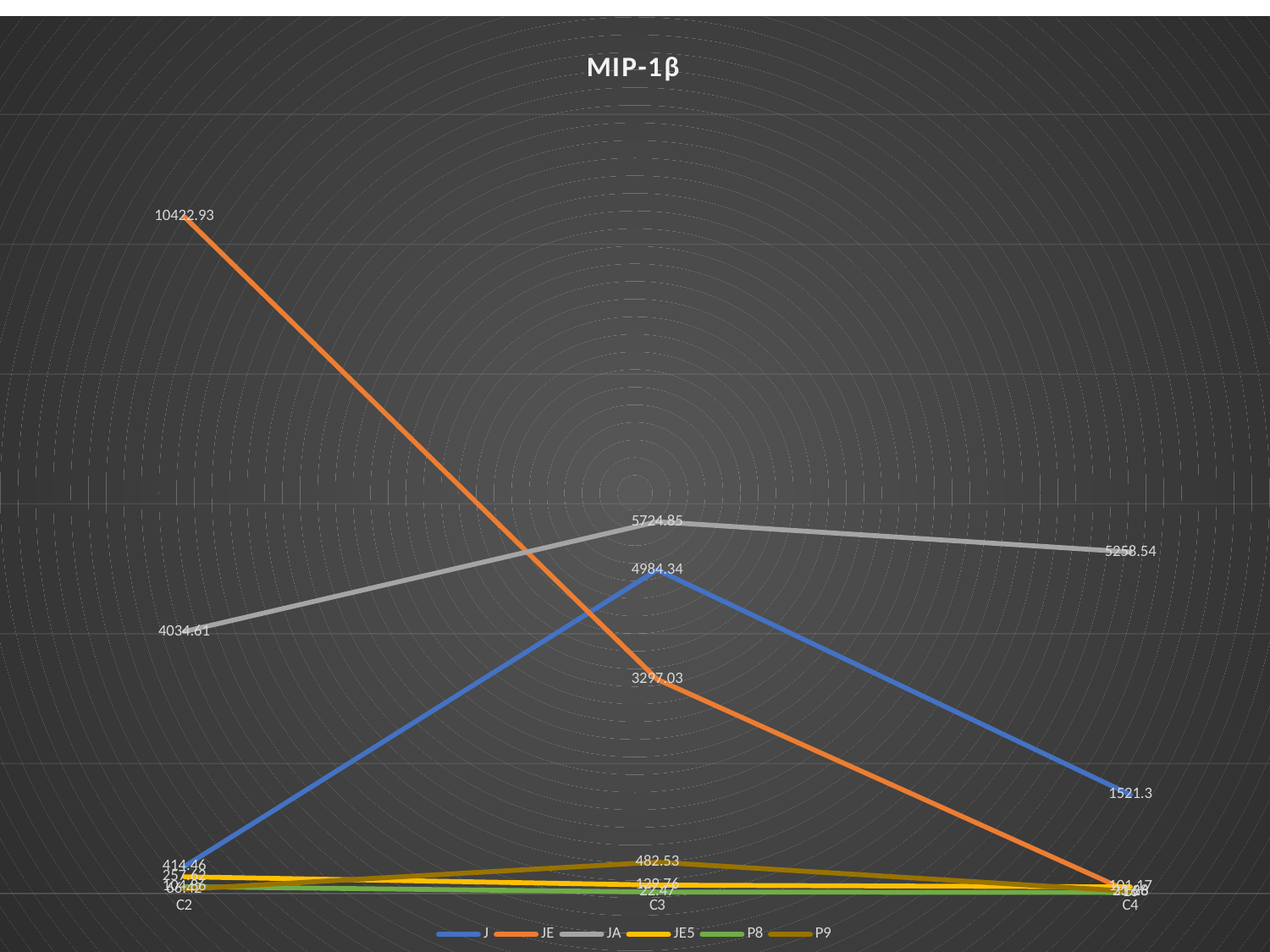
What is the value of the JA series at C4? 5258.54 What is the value of the J series at C4? 1521.3 What is the difference between the JE value at C2 and the JE value at C3? 7125.9 Does the JE series rise or fall from C2 to C4? fall What is the value of the J series at C3? 4984.34 What type of chart is shown on the slide? line chart How many series does the legend list? 6 What is the title of the chart? MIP-1β What is the value of the JE series at C2? 10422.93 Which series has the highest value at C2? JE How many categories are shown on the x axis? 3 What is the value of the JA series at C3? 5724.85